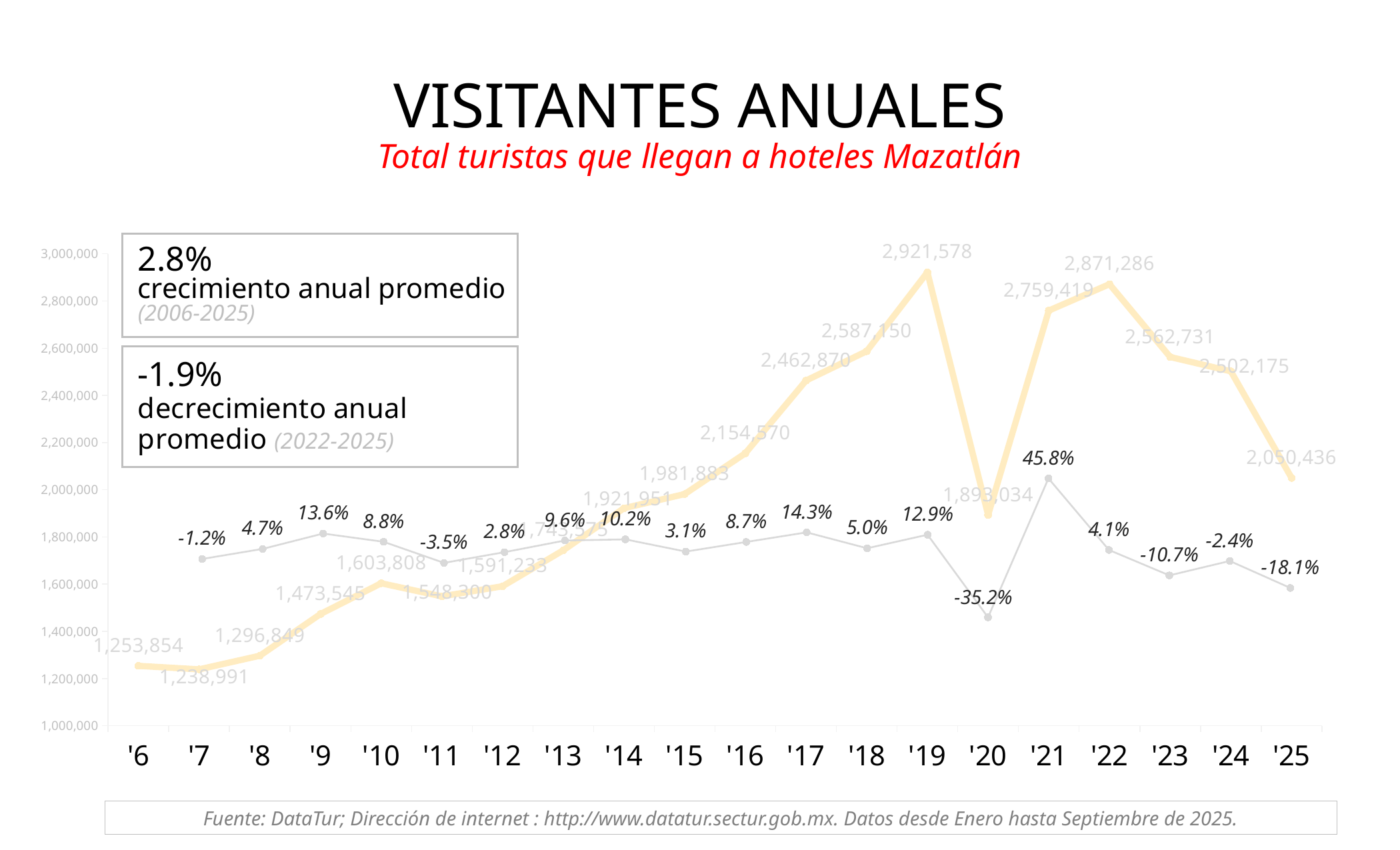
Which year has the highest number of visitors? '19 What is the number of visitors shown for '19? 2,921,578 Is the number of visitors for '16 greater or less than 2,000,000? greater What percentage change is shown for '21? 45.8% What is the number of visitors shown for '25? 2,050,436 Which year has more visitors, '17 or '24? '24 What is the difference in visitors between '22 and '23? 308,555 What type of chart is shown on the slide? line chart What percentage change is shown for '23? -10.7% What is the average annual growth rate stated for 2006-2025? 2.8% Which year has the lowest percentage change? '20 How many years are shown on the x axis? 20